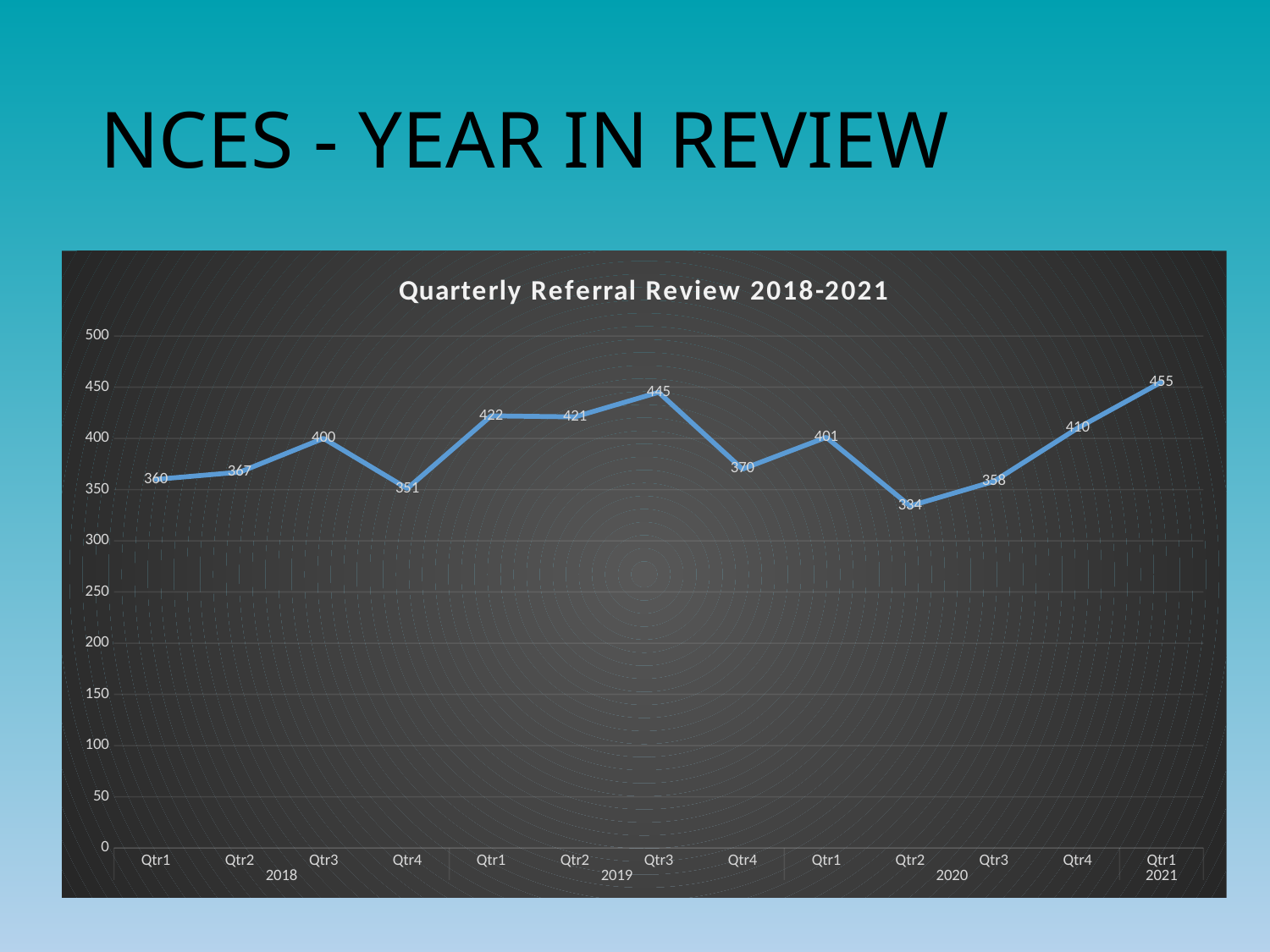
Which quarter has the highest value? Qtr1 2021 What is the value for Qtr3 2018? 400 Is the value for Qtr4 2018 greater or less than 400? less What kind of chart is shown? line chart Which is larger, the value for Qtr1 2019 or the value for Qtr1 2020? Qtr1 2019 Which quarter has the lowest value? Qtr2 2020 What is the value for Qtr1 2021? 455 What is the value for Qtr2 2020? 334 Do the values rise or fall from Qtr2 2020 to Qtr1 2021? rise How many quarterly data points are plotted? 13 What is the difference between the values for Qtr3 2019 and Qtr4 2019? 75 What is the title of the chart? Quarterly Referral Review 2018-2021